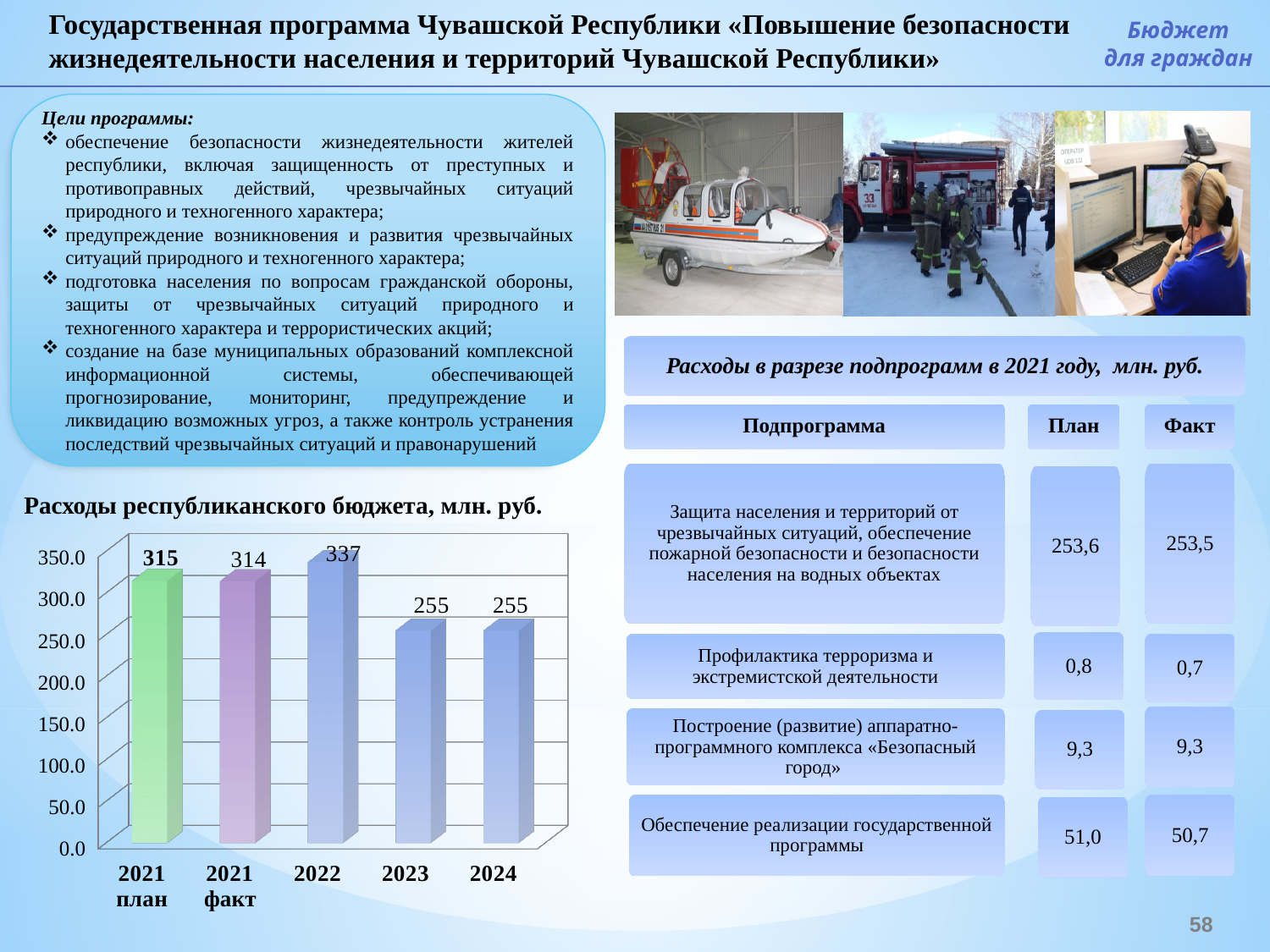
What is the value for 2022 in the chart 'Расходы республиканского бюджета, млн. руб.'? 337 How many categories are shown on the x axis of the chart? 5 What kind of chart is shown on the slide? bar chart Is the value for 2023 in the chart greater or less than 300.0? less What is the difference between the values for 2022 and 2023 in the chart? 82 What is the value for '2021 факт' in the chart? 314 What is the difference between '2021 план' and '2021 факт' in the chart? 1 Which is larger in the chart: the value for 2022 or the value for '2021 план'? 2022 What is the title of the chart on the slide? Расходы республиканского бюджета, млн. руб. Which category has the highest value in the chart? 2022 What is the value for '2021 план' in the chart? 315 What is the value for 2024 in the chart? 255